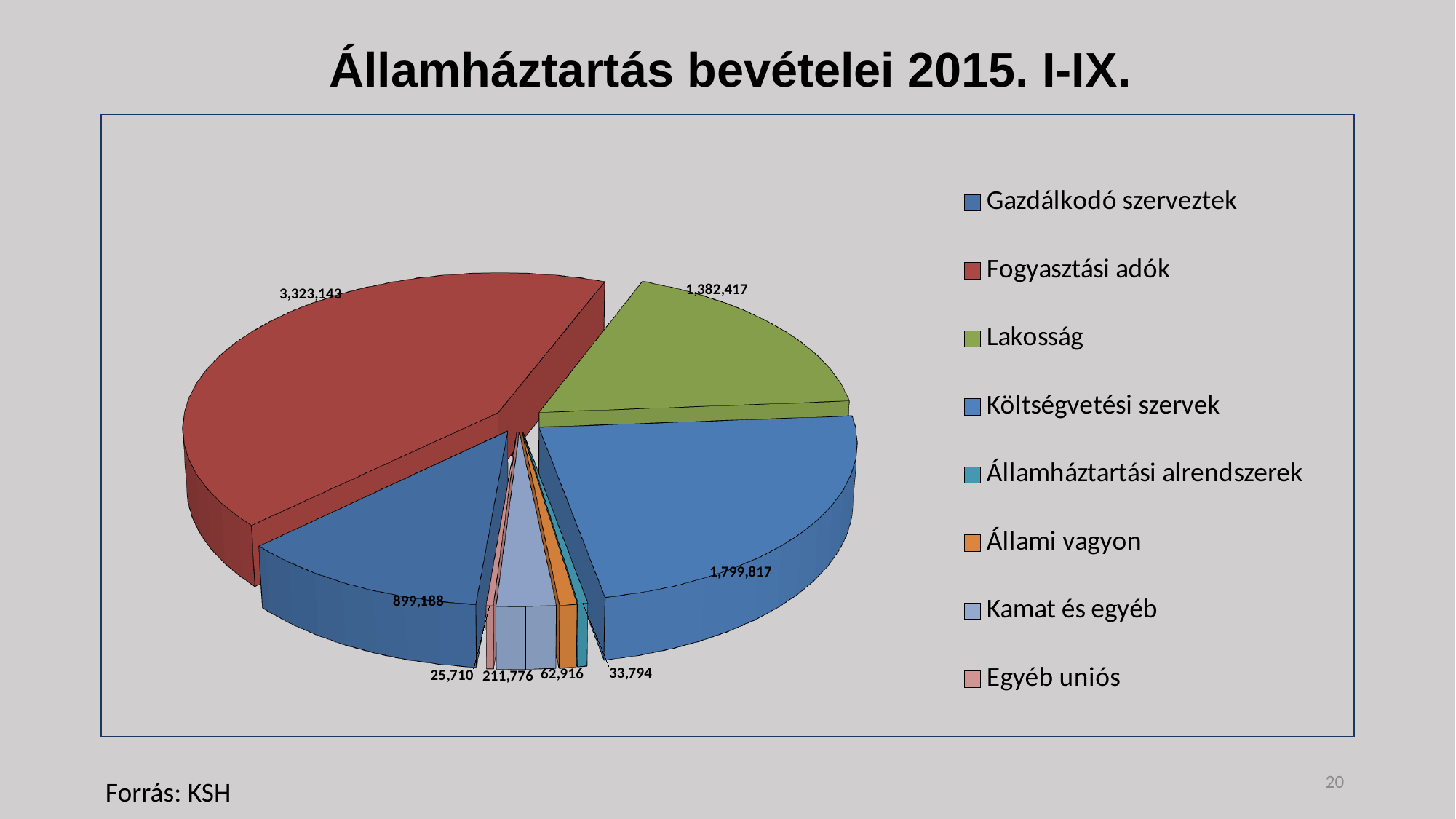
What kind of chart is shown on the slide? Pie chart Which category has the smallest slice of the pie? Egyéb uniós What is the value for Kamat és egyéb? 211,776 What is the difference between the values for Fogyasztási adók and Költségvetési szervek? 1,523,326 What is the value for Lakosság? 1,382,417 What is the difference between the values for Állami vagyon and Államháztartási alrendszerek? 29,122 What is the value for Fogyasztási adók? 3,323,143 What is the title of the chart? Államháztartás bevételei 2015. I-IX. Which is larger, Lakosság or Gazdálkodó szerveztek? Lakosság Which category has the largest slice of the pie? Fogyasztási adók What is the value for Állami vagyon? 62,916 How many slices does the pie chart have? 8